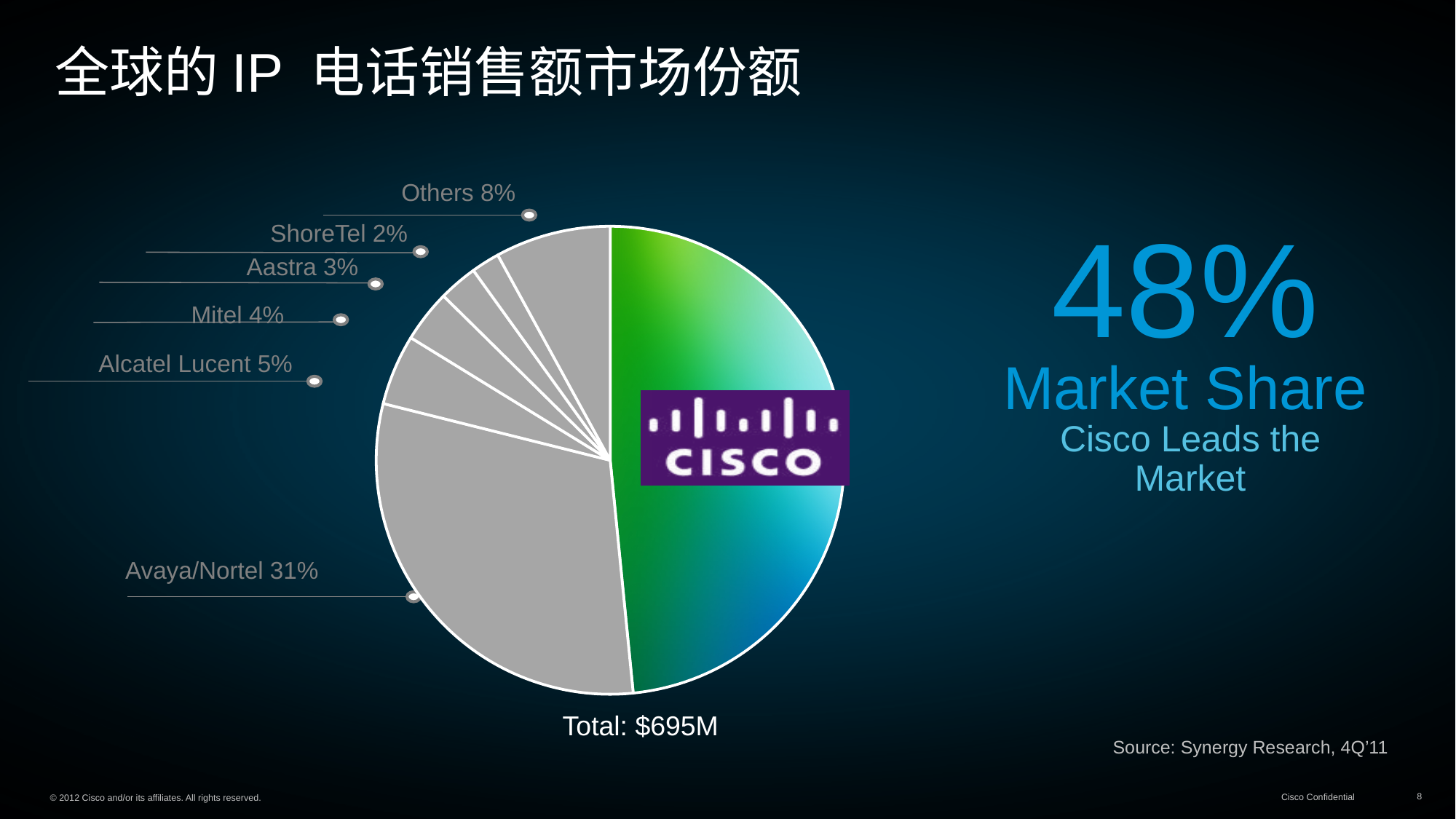
Which named company has the smallest slice of the pie? ShoreTel What is the difference in percentage points between Cisco and Avaya/Nortel? 17 What is the value shown for Alcatel Lucent? 5% What is the value shown for Others? 8% Which company has the largest slice of the pie? Cisco What is the value shown for Mitel? 4% What share of the pie does Cisco hold? 48% How many slices does the pie chart have? 7 What kind of chart is shown on the slide? pie chart Which is larger, the slice for Aastra or the slice for Alcatel Lucent? Alcatel Lucent What is the value shown for ShoreTel? 2% What share of the pie does Avaya/Nortel hold? 31%